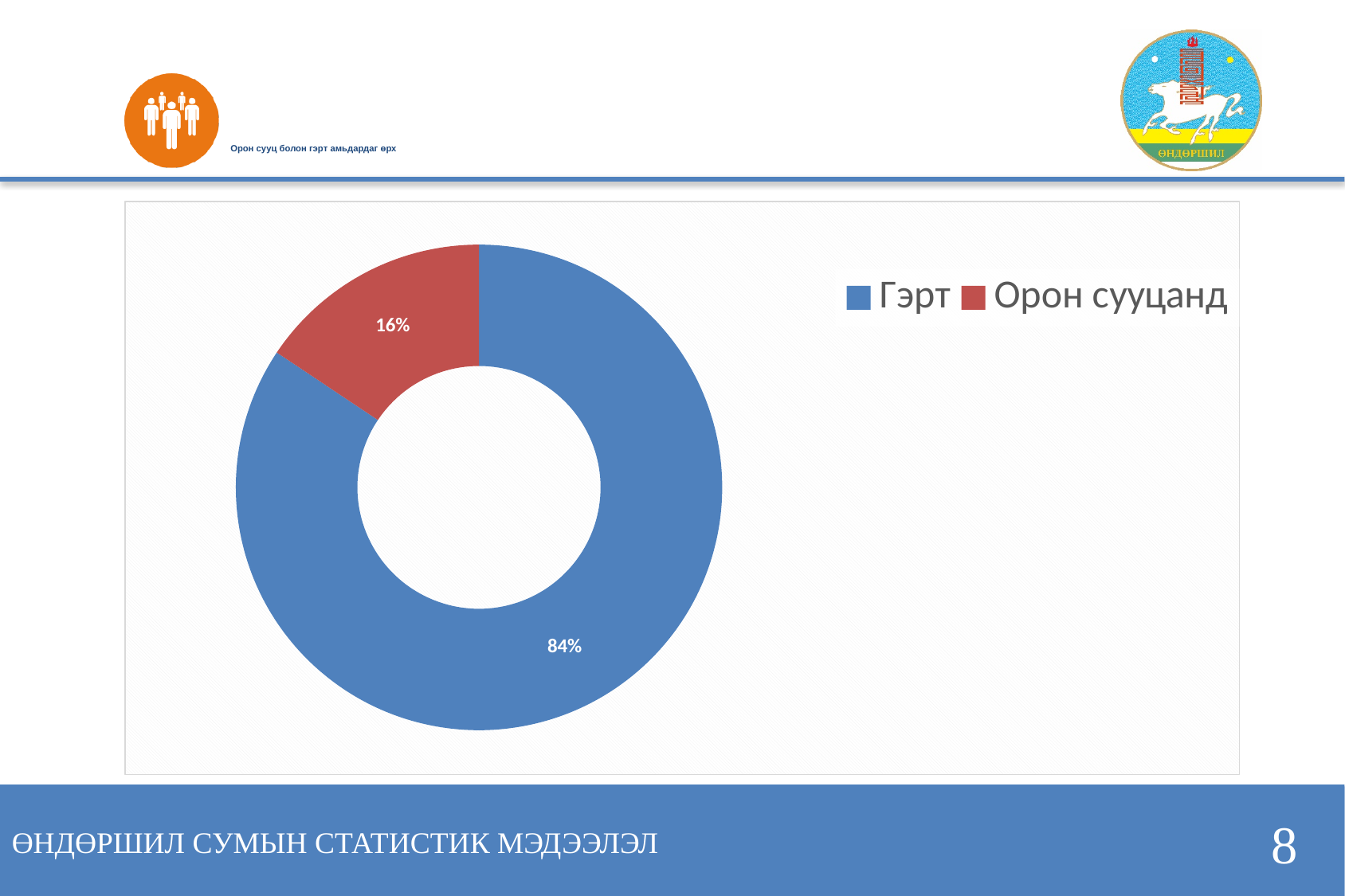
What kind of chart is shown on the slide? Doughnut (pie) chart What colour is the Орон сууцанд segment in the chart? Red What share of the doughnut chart does Гэрт represent? 84% What is the difference in percentage points between the Гэрт and Орон сууцанд shares? 68 What share of the doughnut chart does Орон сууцанд represent? 16% Which category has the smallest share in the chart? Орон сууцанд How many categories are shown in the chart? 2 What colour is the Гэрт segment in the chart? Blue How many entries does the legend list? 2 Which is larger, the share for Гэрт or the share for Орон сууцанд? Гэрт Which category has the largest share in the chart? Гэрт